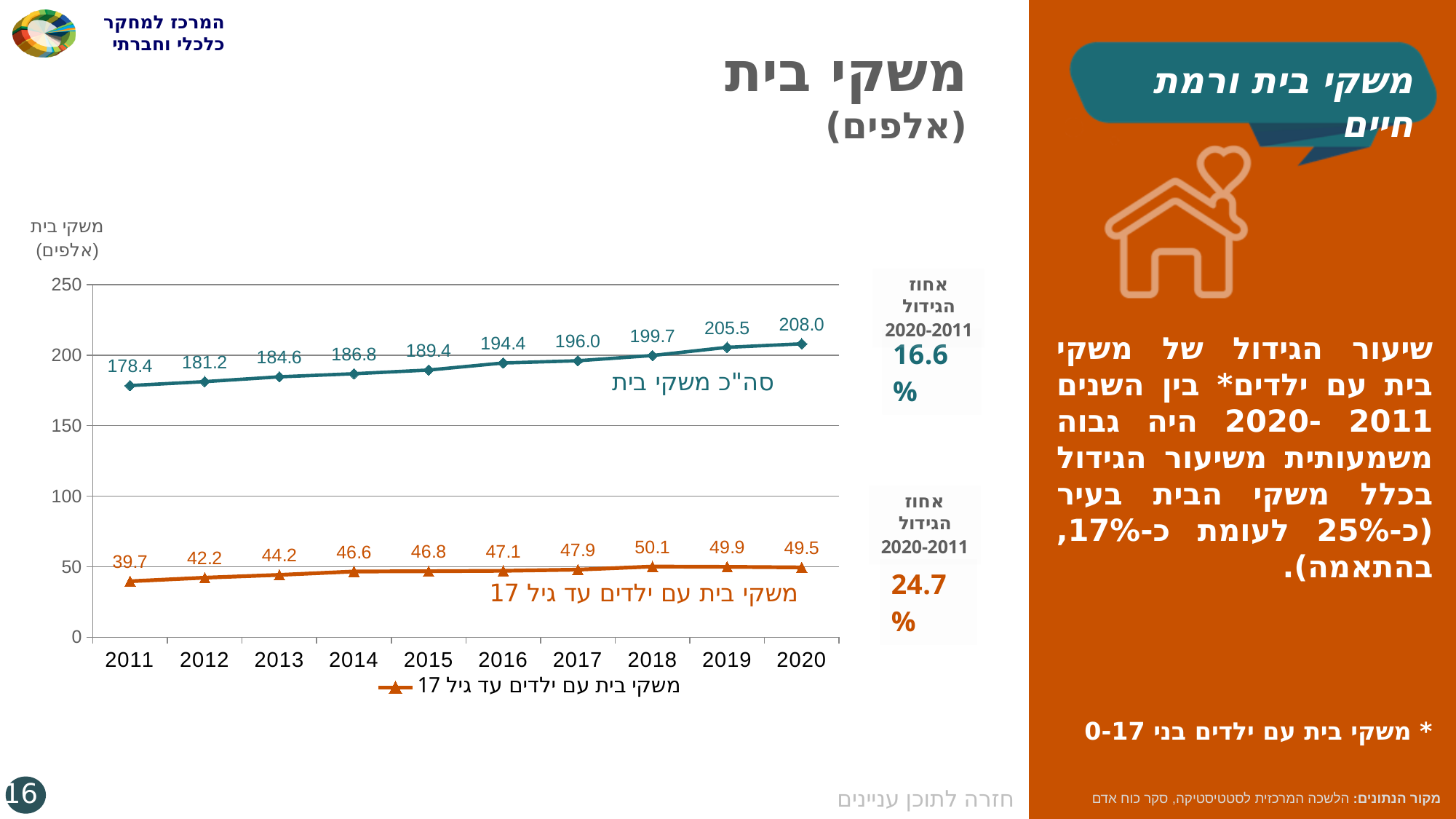
What was the value for households with children up to age 17 (משקי בית עם ילדים עד גיל 17) in 2018? 50.1 In which year was the value for households with children up to age 17 the highest? 2018 What type of chart is shown on the slide? line chart In which year was the total number of households the lowest? 2011 How many years are shown on the x axis? 10 What growth percentage for 2011-2020 is shown next to the households-with-children line? 24.7% Which is larger: the households-with-children value in 2014 or in 2013? 2014 What was the total number of households (סה"כ משקי בית) in 2020? 208.0 What is the difference between the households-with-children value in 2019 and in 2020? 0.4 What is the difference between the total households value in 2020 and in 2011? 29.6 Is the total households value in 2019 greater or less than 200? greater What was the total number of households (סה"כ משקי בית) in 2011? 178.4